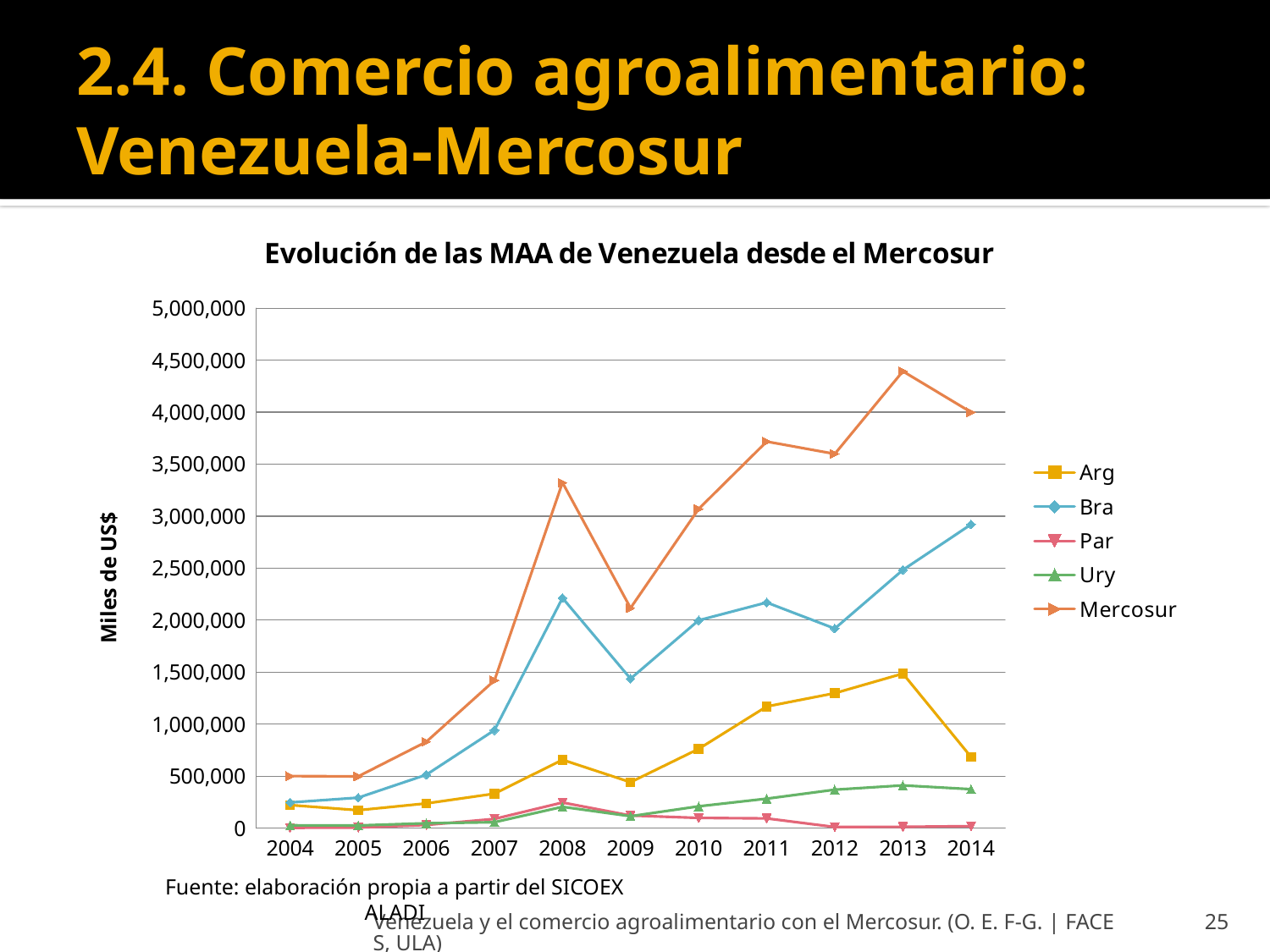
Does the Mercosur series rise or fall from 2004 to 2008? rise Is the value for Arg in 2014 greater or less than 500,000? greater Which series has the lowest value in 2014? Par Is the value for Par in 2012 greater or less than 500,000? less What is the label on the y axis? Miles de US$ What kind of chart is shown on the slide? line chart Which is larger in 2013, the value for Arg or the value for Ury? Arg How many years are plotted along the x axis? 11 How many series does the legend list? 5 Is the value for Bra in 2008 greater or less than 2,000,000? greater In which year does the Mercosur series reach its highest value? 2013